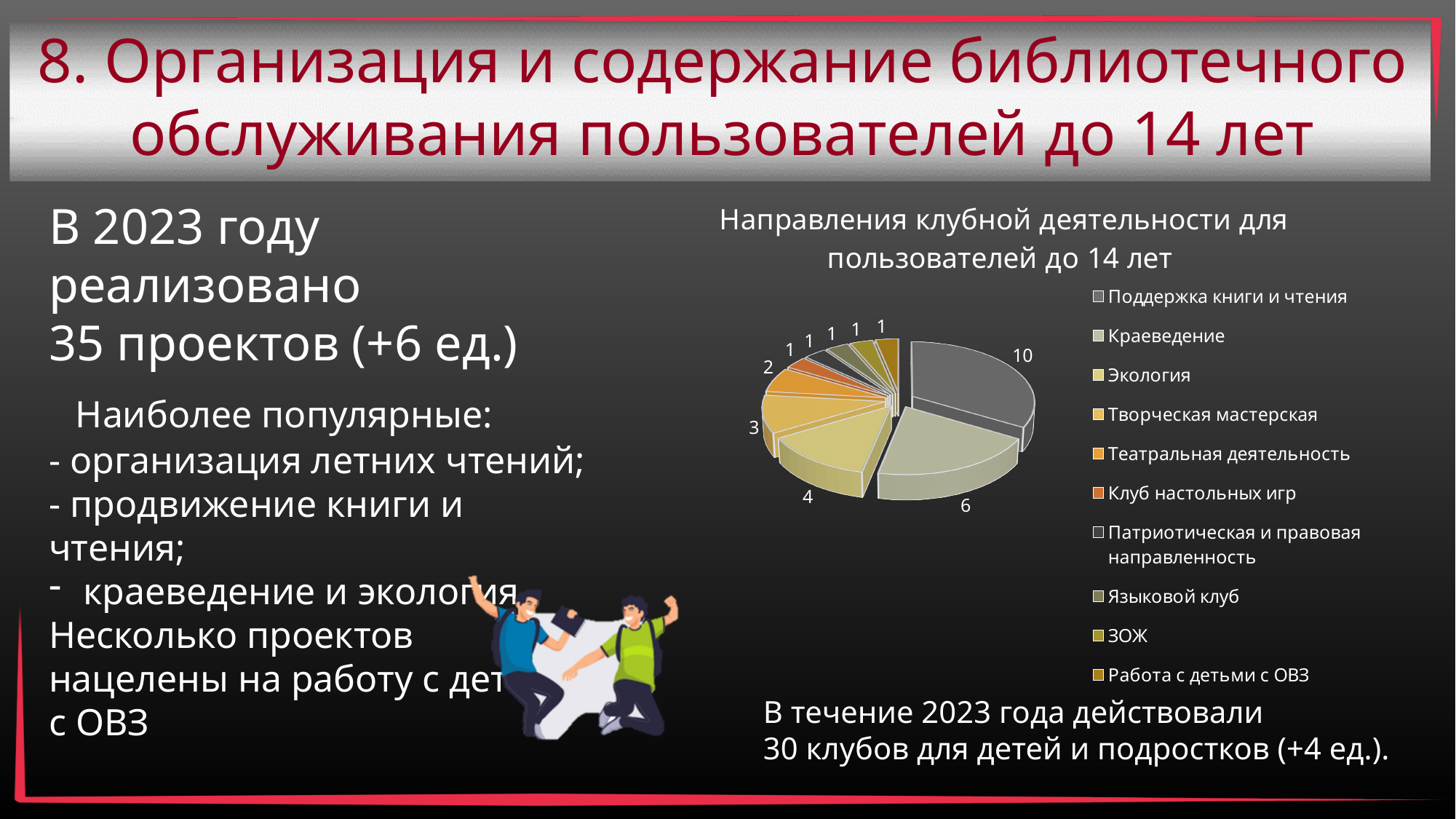
What is the title of the chart on the slide? Направления клубной деятельности для пользователей до 14 лет How many categories does the legend of the pie chart list? 10 What is the value for Краеведение in the pie chart? 6 What is the total of all the values shown in the pie chart? 30 What type of chart is shown on the slide? Pie chart What is the value for Экология in the pie chart? 4 Which is larger in the pie chart: Экология or Творческая мастерская? Экология What is the value for Творческая мастерская in the pie chart? 3 What is the value for Поддержка книги и чтения in the pie chart? 10 What is the value for Театральная деятельность in the pie chart? 2 Which category has the largest slice in the pie chart? Поддержка книги и чтения What is the difference between the values for Поддержка книги и чтения and Краеведение? 4